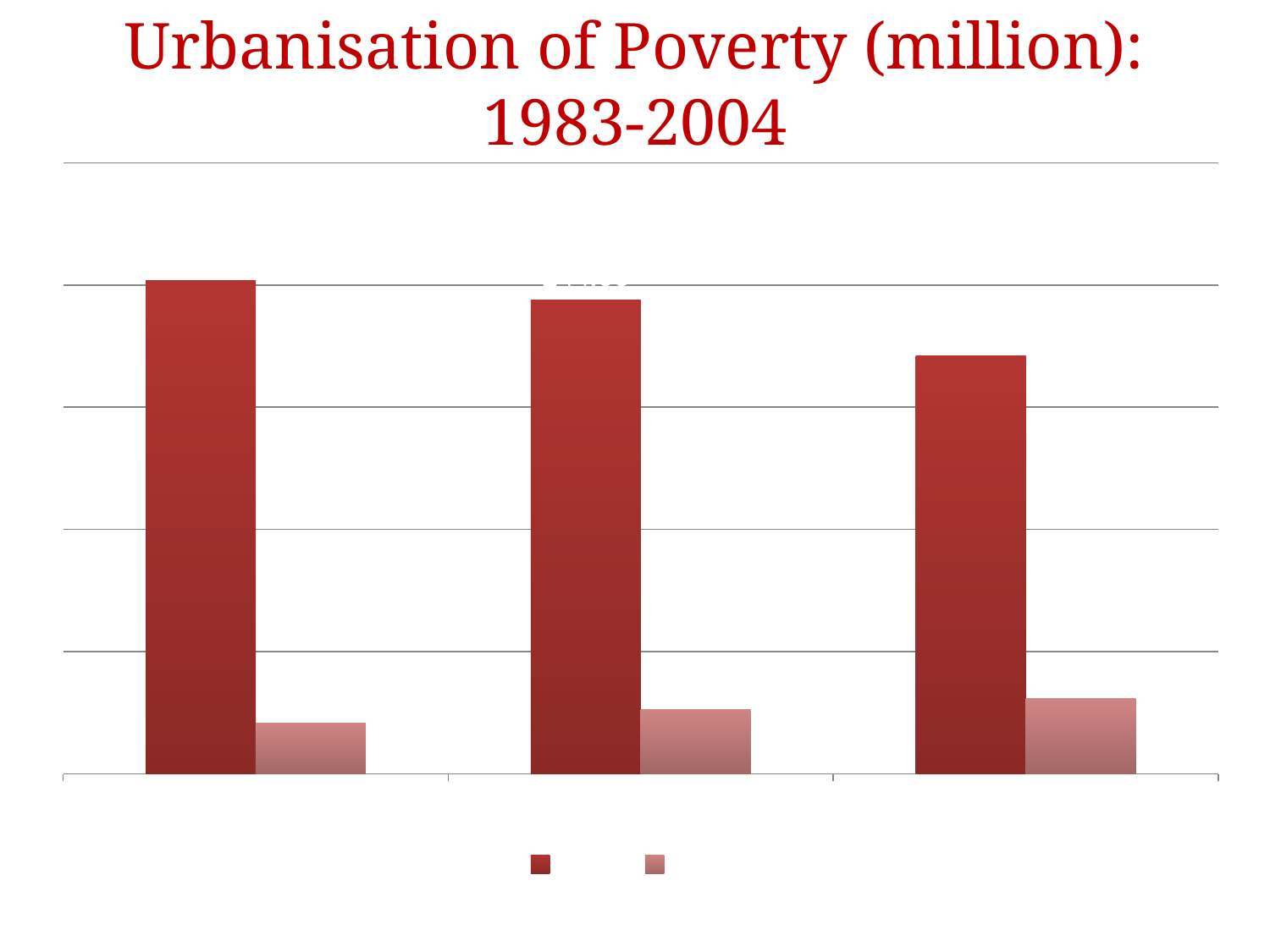
How many series does the legend below the chart list? 2 Which group of bars has the shortest dark red bar: the leftmost, middle, or rightmost? rightmost Which group of bars has the tallest light red bar: the leftmost, middle, or rightmost? rightmost Which group of bars has the tallest dark red bar: the leftmost, middle, or rightmost? leftmost What kind of chart is shown on the slide? bar chart How many groups of bars (categories) are plotted in the chart? 3 What is the title of the chart on the slide? Urbanisation of Poverty (million): 1983-2004 In the rightmost group of bars, which bar is taller: the dark red bar or the light red bar? the dark red bar Which colour is the first series in the legend: dark red or light red? dark red Do the dark red bars rise or fall from left to right across the chart? fall Which group of bars has the shortest light red bar: the leftmost, middle, or rightmost? leftmost Do the light red bars rise or fall from left to right across the chart? rise